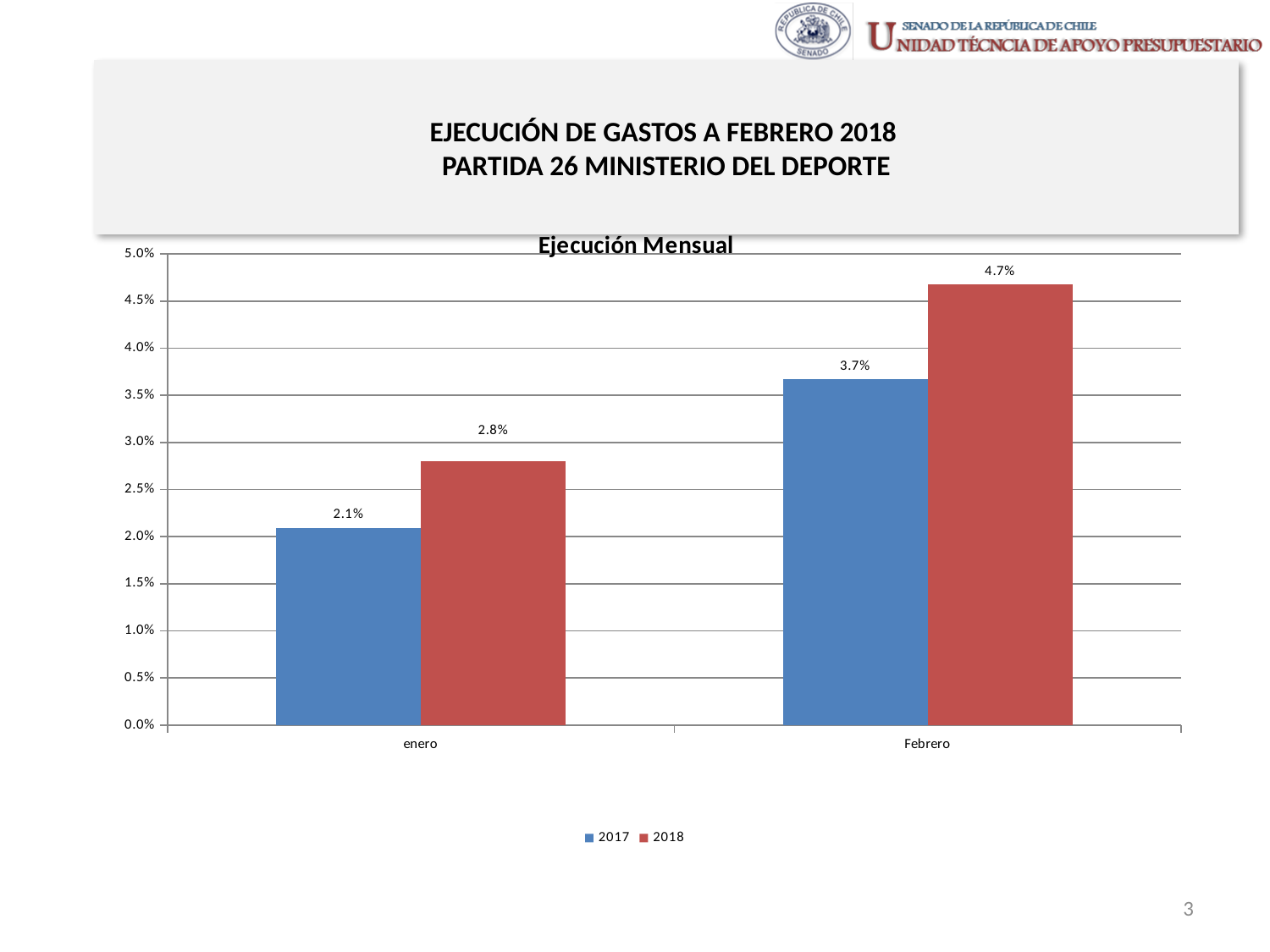
What is the value for 2018 in Febrero? 4.7% What is the title of the chart? Ejecución Mensual What is the difference between the 2018 and 2017 values in Febrero? 1.0% How many categories are shown on the x axis? 2 What kind of chart is shown? bar chart Which series has the highest value in Febrero? 2018 How many series does the legend list? 2 Which bar has the lowest value on the chart? 2017 in enero What is the value for 2017 in Febrero? 3.7% What is the value for 2017 in enero? 2.1% Which is larger, the 2018 value in enero or the 2017 value in Febrero? 2017 in Febrero What is the value for 2018 in enero? 2.8%